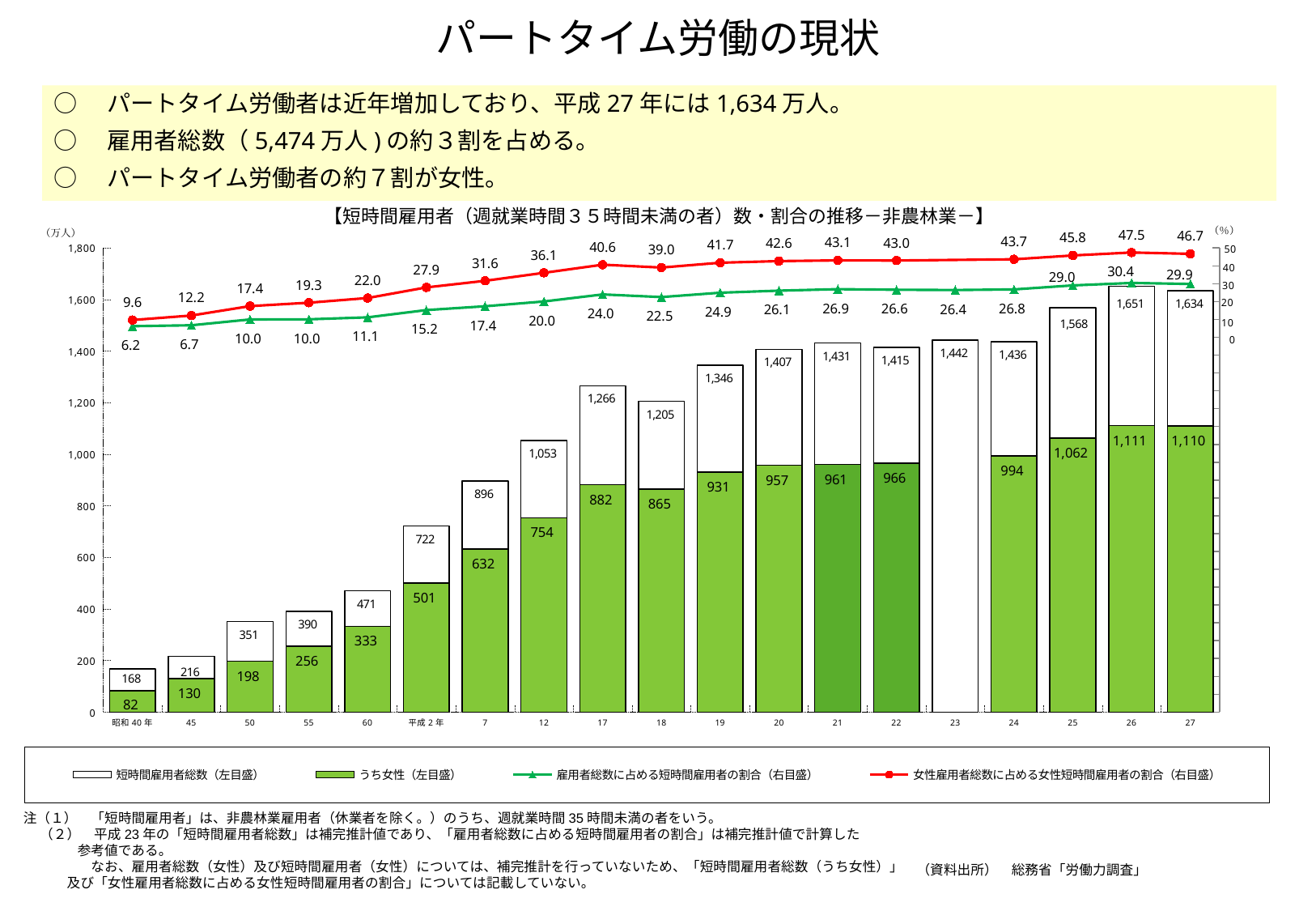
Which year has the highest 短時間雇用者総数? 26 (平成26年) What is the value of 短時間雇用者総数 for 平成27年? 1,634 How many series does the legend list? 4 What is the value of 雇用者総数に占める短時間雇用者の割合 for 昭和40年? 6.2 What is the difference between 短時間雇用者総数 and うち女性 for 平成27年? 524 How many years are shown on the x axis of the chart? 19 Which year has the larger 短時間雇用者総数, 平成17年 or 平成18年? 平成17年 What is the value of うち女性 for 平成26年? 1,111 What is the value of 女性雇用者総数に占める女性短時間雇用者の割合 for 平成26年? 47.5 Which year has the lowest うち女性 value? 昭和40年 What kind of chart is shown on the slide? Combined bar and line chart Does the 女性雇用者総数に占める女性短時間雇用者の割合 line generally rise or fall from 昭和40年 to 平成27年? Rise